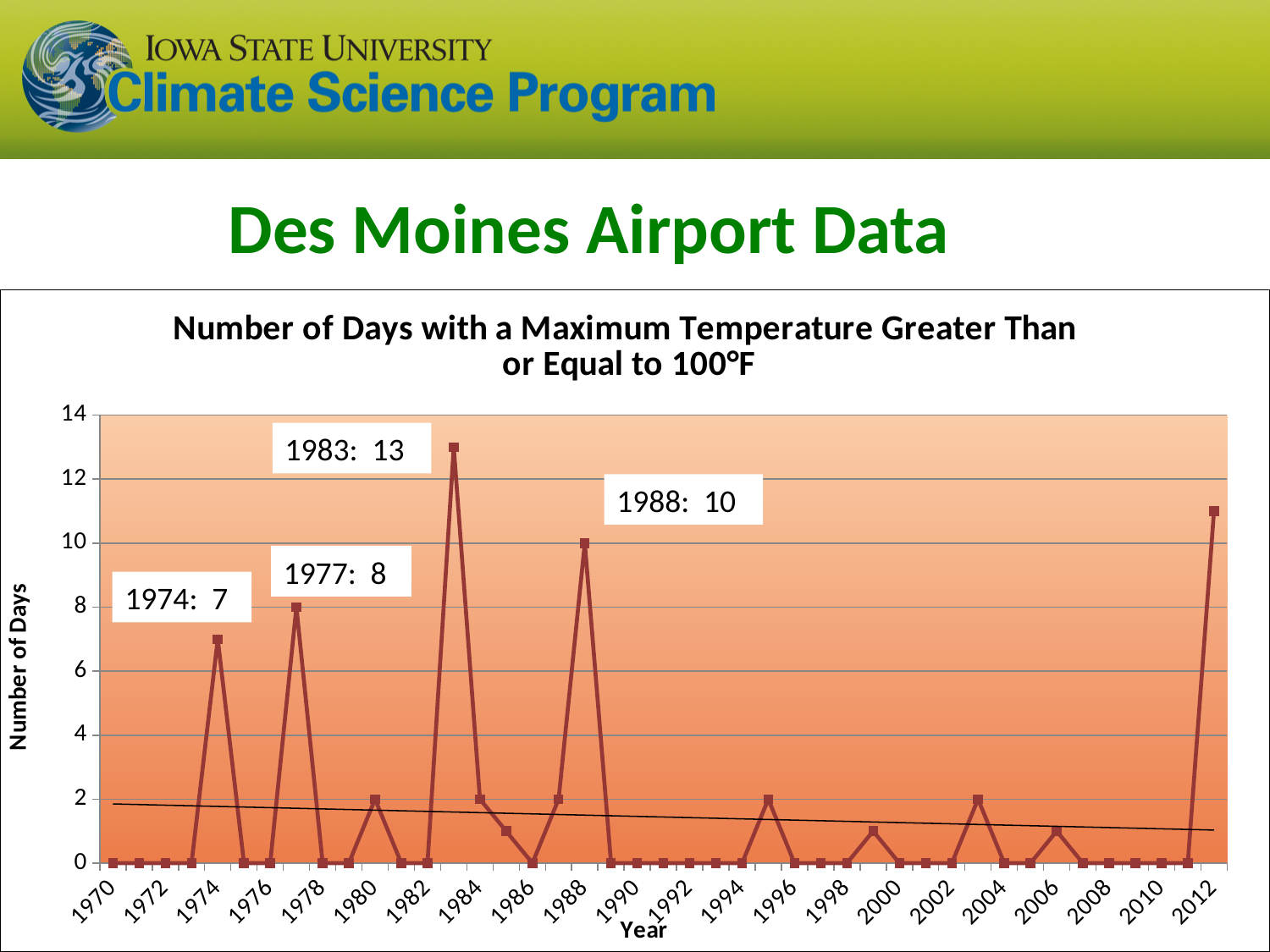
What is the value labelled for 1988? 10 What is the title of the vertical axis? Number of Days What is the difference between the values for 1983 and 1988? 3 What is the value labelled for 1977? 8 Which year has the larger value, 1974 or 1977? 1977 Does the straight trend line drawn across the chart rise or fall from 1970 to 2012? fall What kind of chart is shown on the slide? line chart Is the value for 2012 greater or less than 10? greater Which year has the highest number of days with a maximum temperature greater than or equal to 100°F? 1983 What is the value labelled for 1974? 7 How many days with a maximum temperature of at least 100°F were recorded in 1983? 13 What is the value for 1980? 2